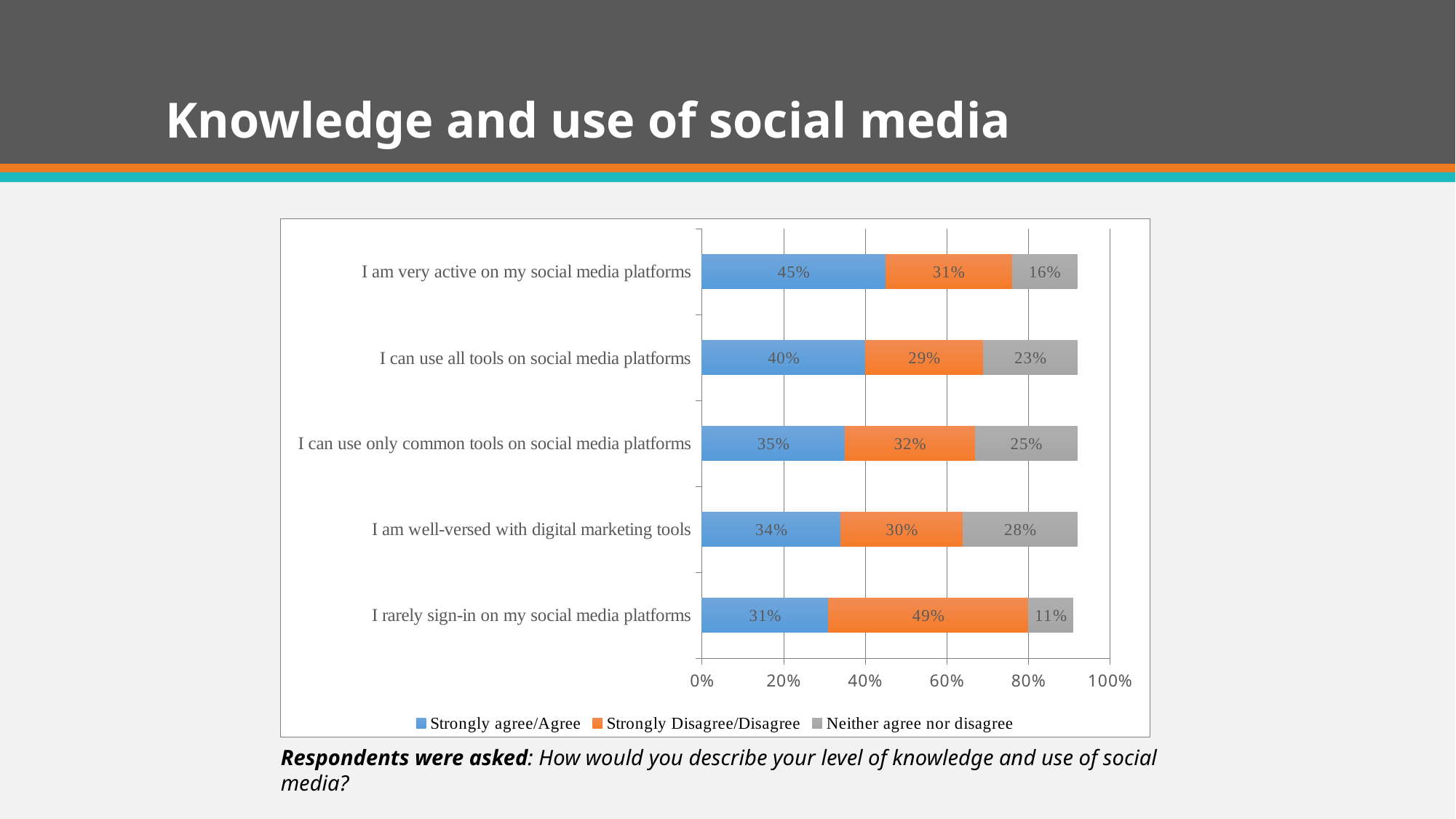
What is the Neither agree nor disagree value for "I am well-versed with digital marketing tools"? 28% Which statement has the lowest Neither agree nor disagree value? I rarely sign-in on my social media platforms How many series does the legend list? 3 What is the total of the stacked bar for "I rarely sign-in on my social media platforms"? 91% What is the Strongly Disagree/Disagree value for "I rarely sign-in on my social media platforms"? 49% What is the difference between the Strongly agree/Agree values for "I am very active on my social media platforms" and "I rarely sign-in on my social media platforms"? 14% Which colour represents the Strongly Disagree/Disagree series in the chart? Orange What is the Strongly agree/Agree value for "I am very active on my social media platforms"? 45% Which is larger: the Strongly Disagree/Disagree value for "I can use only common tools on social media platforms" or for "I can use all tools on social media platforms"? I can use only common tools on social media platforms How many statements (categories) are plotted in the chart? 5 Which statement has the highest Strongly agree/Agree value? I am very active on my social media platforms What kind of chart is shown on the slide? Stacked bar chart